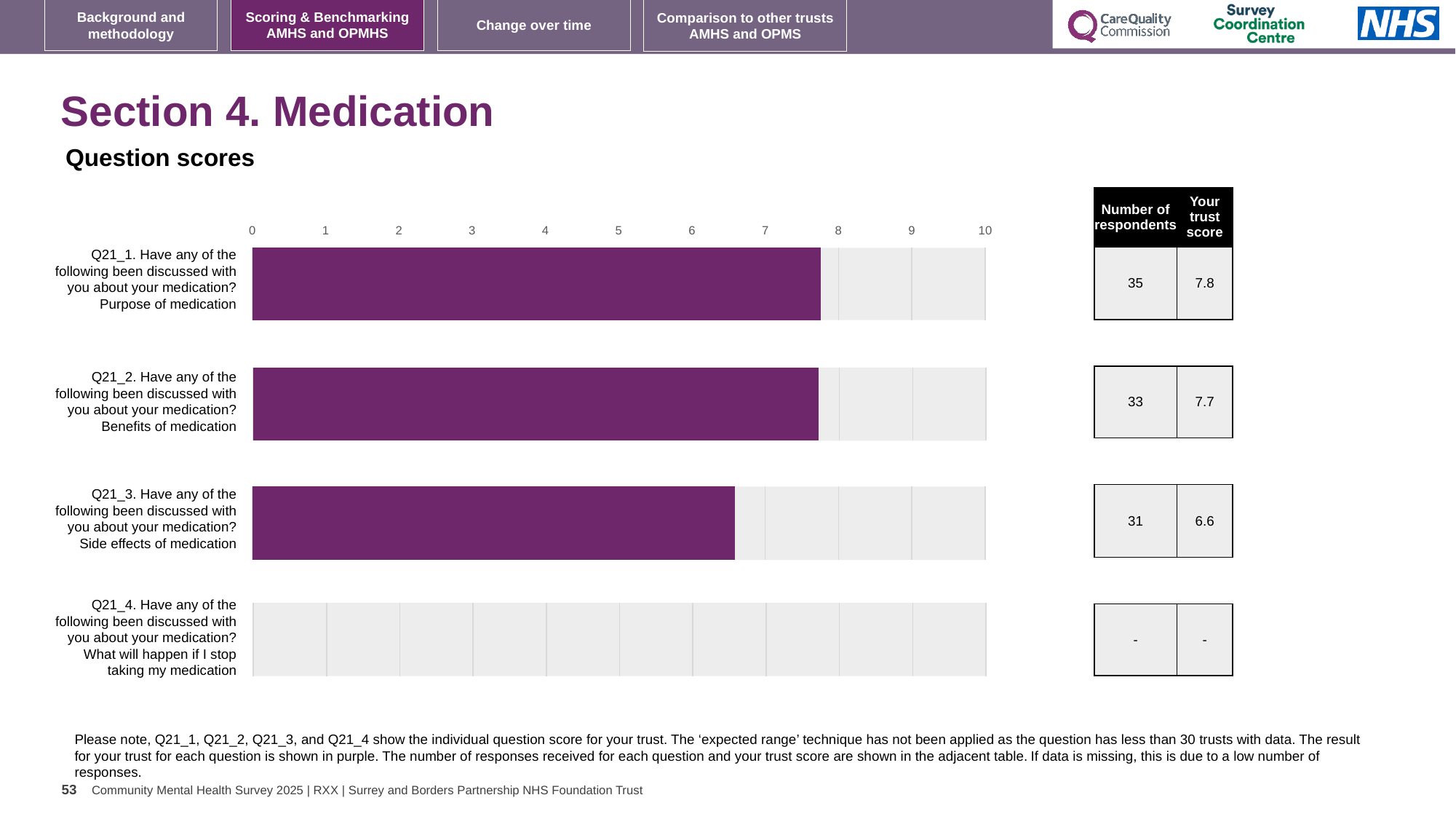
Which question has the highest trust score on the chart? Q21_1. Purpose of medication What is the difference between the trust scores for Q21_1 and Q21_3? 1.2 What colour are the bars showing the trust's results? Purple What is the difference in number of respondents between Q21_1 and Q21_3? 4 What type of chart is shown on the slide? Bar chart What is the trust score for Q21_3 (Side effects of medication)? 6.6 How many respondents answered Q21_2 (Benefits of medication)? 33 Which question has no bar plotted and shows '-' in the table? Q21_4. What will happen if I stop taking my medication What is the trust score for Q21_1 (Purpose of medication)? 7.8 Is the trust score for Q21_3 greater or less than 7? less Which question with a plotted bar has the lowest trust score? Q21_3. Side effects of medication How many question categories are listed on the chart? 4